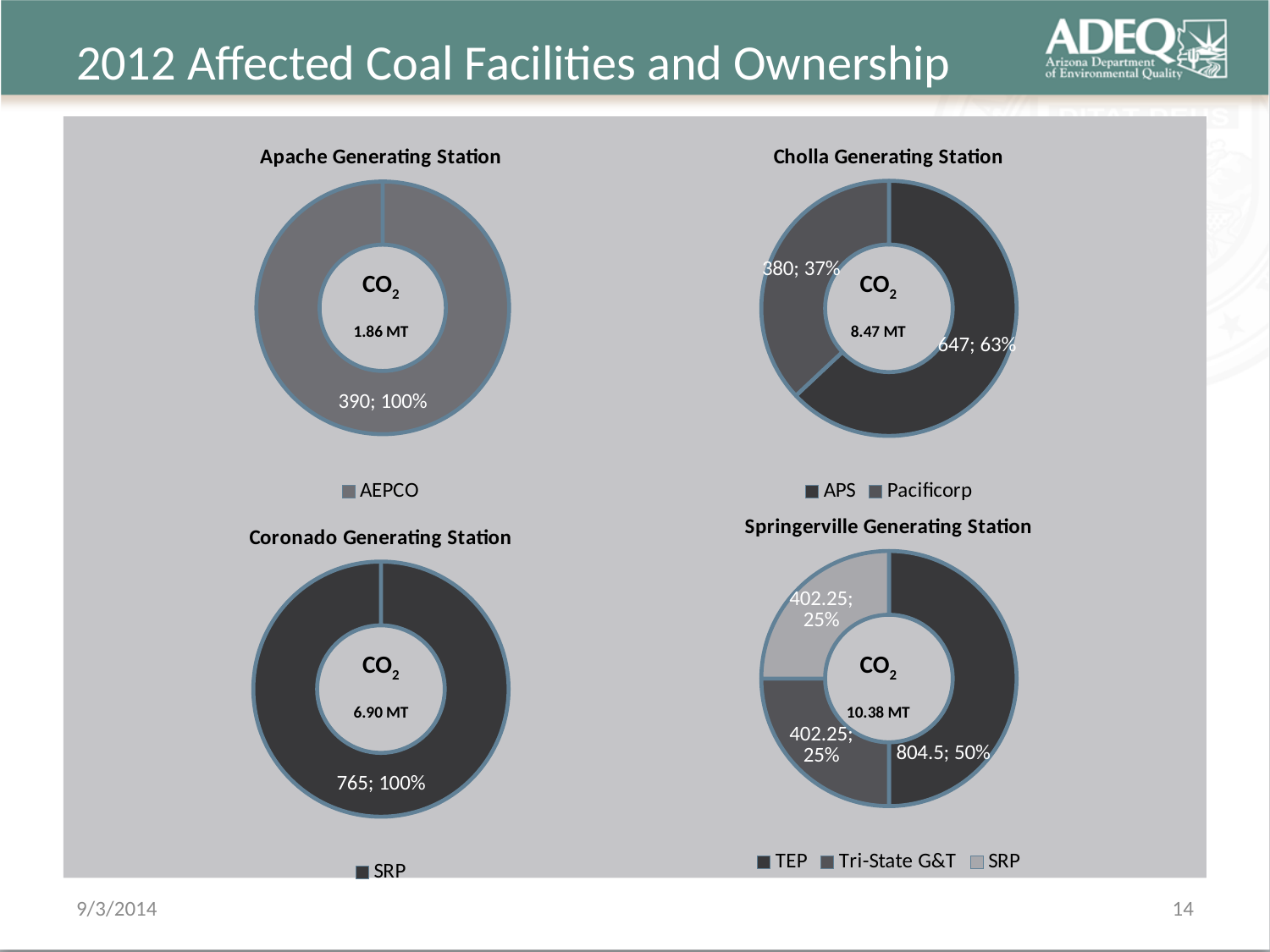
In the Cholla Generating Station chart, what share of the pie does Pacificorp hold? 37% In the Springerville Generating Station chart, what is the difference between the TEP value and the Tri-State G&T value? 402.25 What value is shown for AEPCO in the Apache Generating Station chart? 390 In the Springerville Generating Station chart, what share of the pie does SRP hold? 25% In the Cholla Generating Station chart, what value is shown for APS? 647 In the Cholla Generating Station chart, which owner has the smallest slice? Pacificorp In the Cholla Generating Station chart, which is larger, the APS slice or the Pacificorp slice? APS In the Cholla Generating Station chart, what is the difference between the APS value and the Pacificorp value? 267 How many owners does the legend of the Springerville Generating Station chart list? 3 In the Springerville Generating Station chart, which owner has the largest slice? TEP What kind of chart is the Apache Generating Station chart? Doughnut chart In the Springerville Generating Station chart, what value is shown for TEP? 804.5